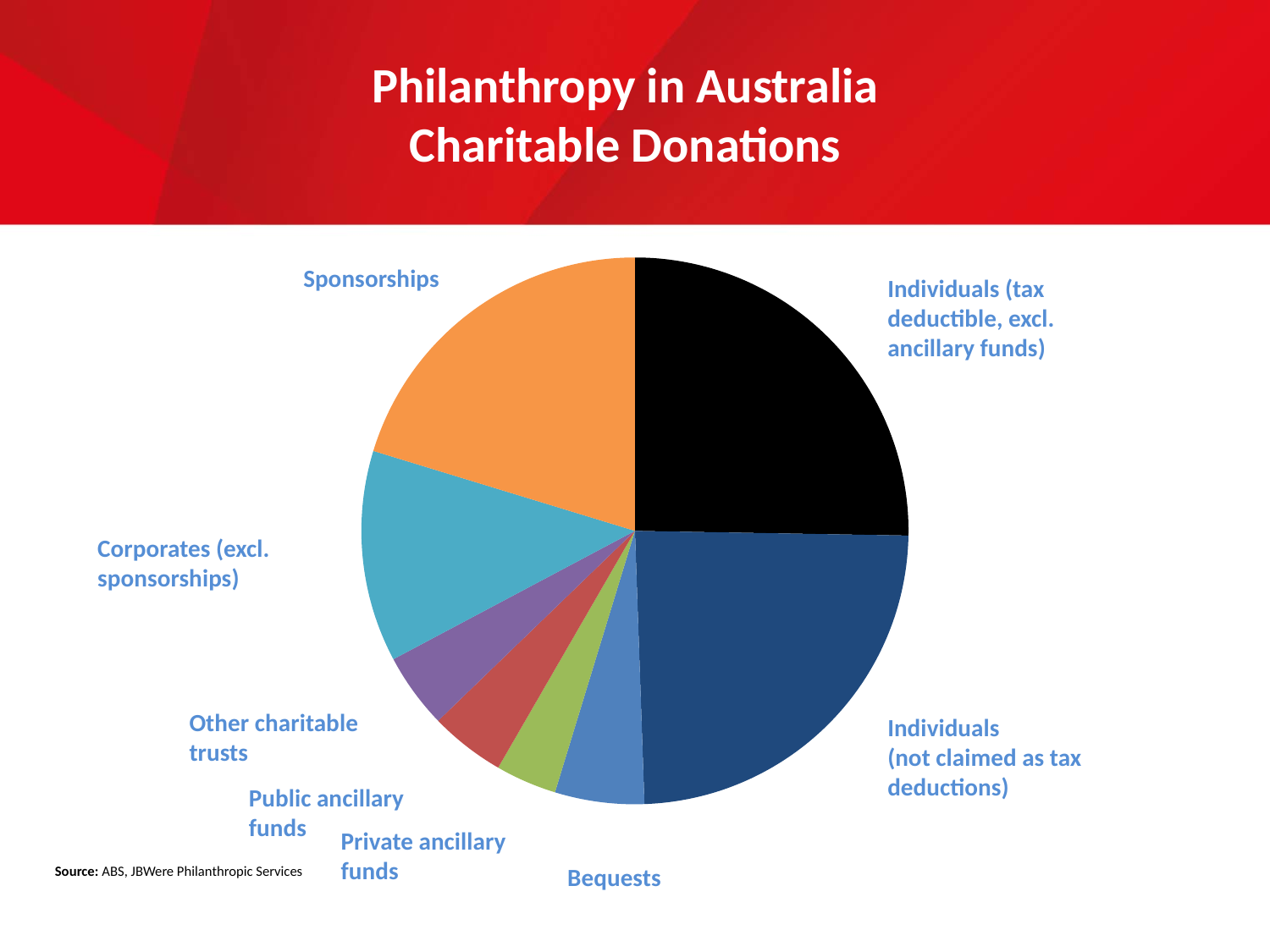
What kind of chart is shown on the slide? pie chart Which is larger, the slice for Sponsorships or the slice for Bequests? Sponsorships What is the title shown on the slide above the chart? Philanthropy in Australia Charitable Donations Which is larger, the slice for Individuals (not claimed as tax deductions) or the slice for Other charitable trusts? Individuals (not claimed as tax deductions) Which is larger, the slice for Sponsorships or the slice for Corporates (excl. sponsorships)? Sponsorships What colour is the slice for Sponsorships? orange How many categories (slices) does the pie chart have? 8